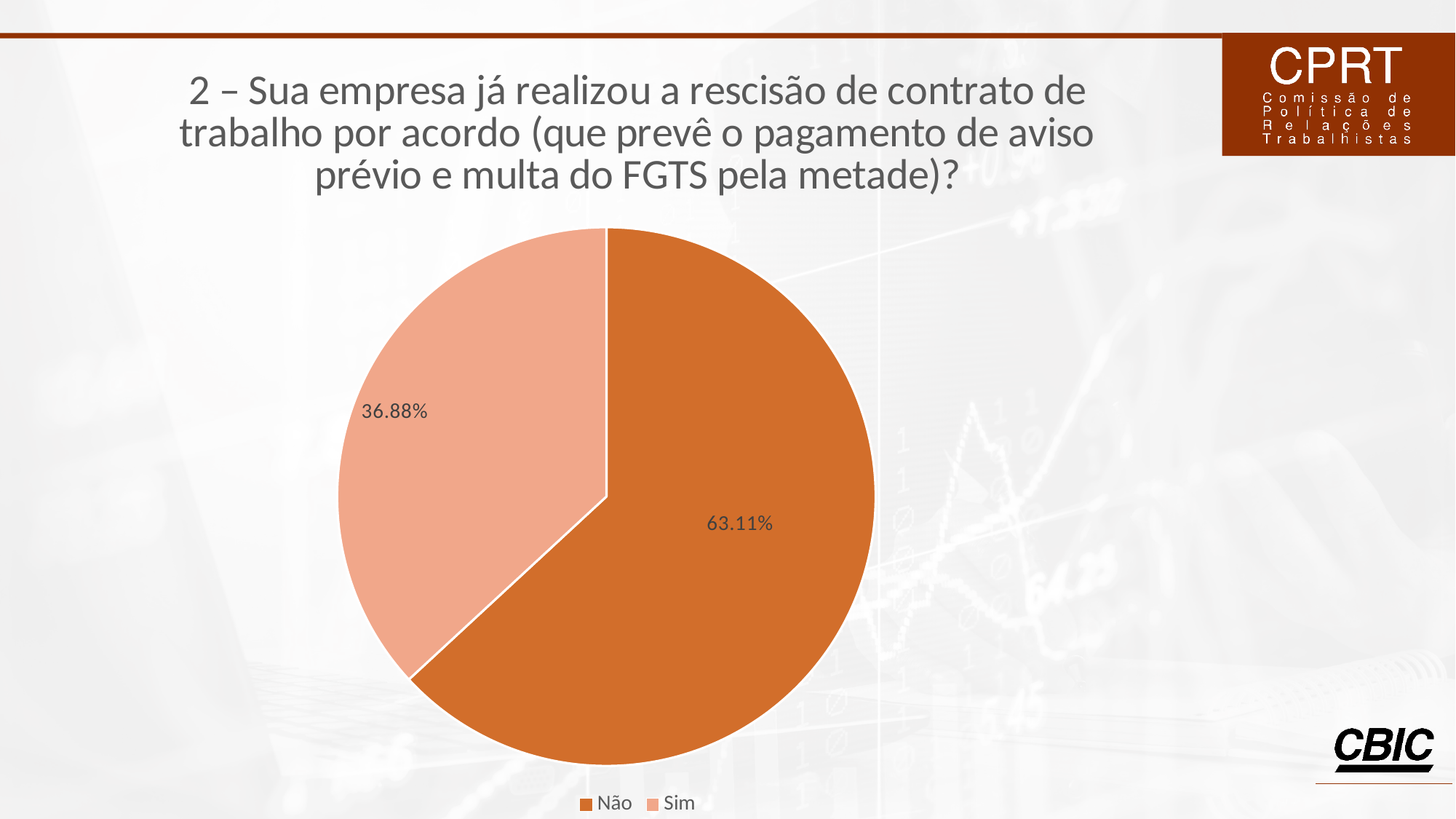
Which slice is larger, "Não" or "Sim"? Não Which category has the largest slice of the pie chart? Não What percentage of the pie chart corresponds to "Não"? 63.11% How many entries does the legend list? 2 Which category has the smallest slice of the pie chart? Sim What is the difference in percentage points between the "Não" and "Sim" slices? 26.23 What percentage of the pie chart corresponds to "Sim"? 36.88% Which legend entry is shown in the darker orange colour? Não What share of the pie does the "Sim" slice represent? 36.88% How many categories are shown in the pie chart? 2 What type of chart is shown on the slide? Pie chart Is the "Não" slice more or less than half of the pie? more